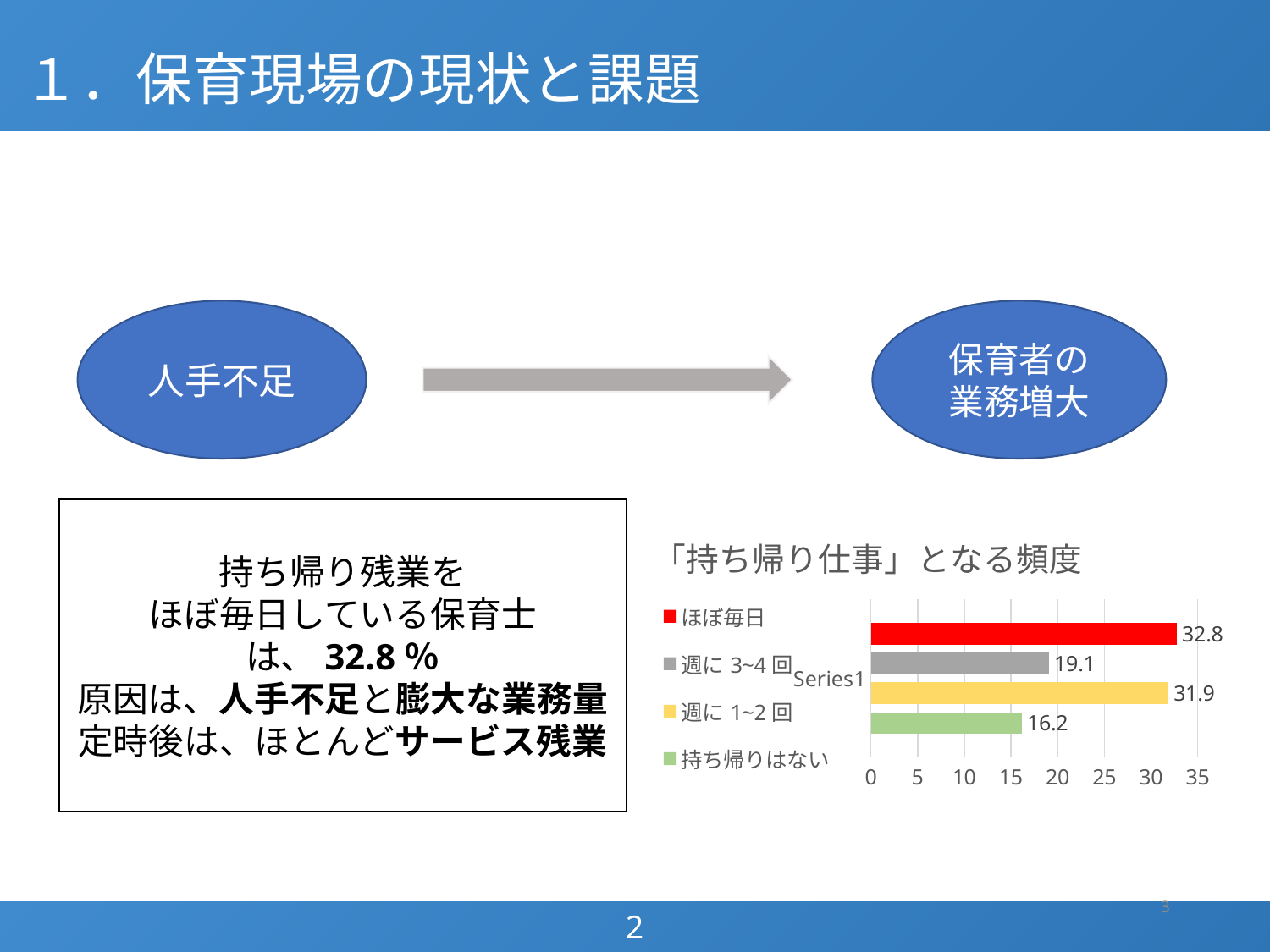
How many entries does the chart's legend list? 4 What is the value for ほぼ毎日 in the chart? 32.8 What is the difference between the values for ほぼ毎日 and 持ち帰りはない? 16.6 What is the title of the chart on the slide? 「持ち帰り仕事」となる頻度 Which legend entry has the lowest value in the chart? 持ち帰りはない What is the value for 週に 3~4 回 in the chart? 19.1 Which legend entry has the highest value in the chart? ほぼ毎日 What colour is the bar for ほぼ毎日 in the chart? red What is the value for 持ち帰りはない in the chart? 16.2 What type of chart is shown on the slide? bar chart What is the value for 週に 1~2 回 in the chart? 31.9 Which is larger, the value for 週に 3~4 回 or the value for 持ち帰りはない? 週に 3~4 回